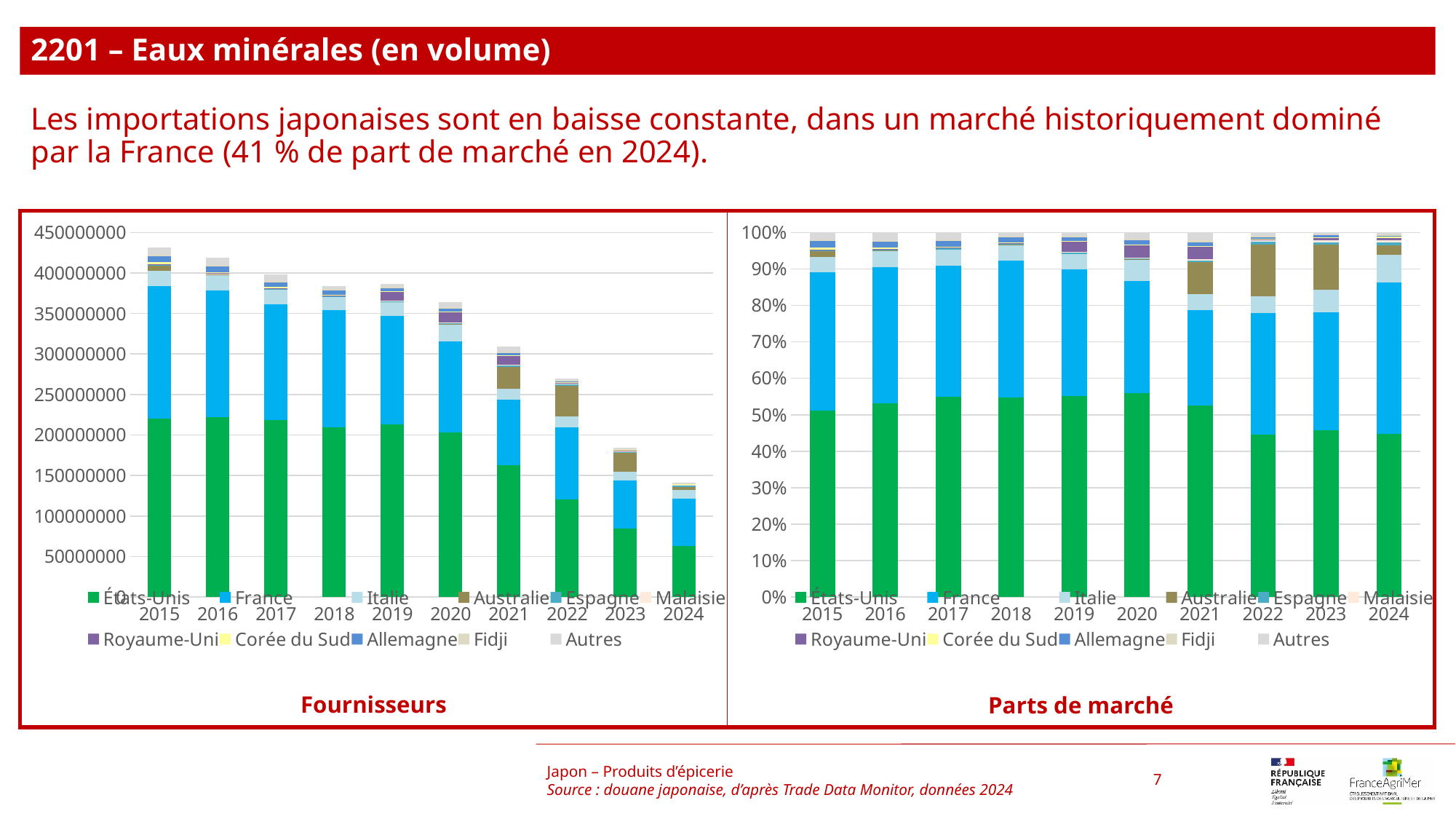
In the 'Fournisseurs' chart, do the total bar heights rise or fall from 2015 to 2024? fall In the 'Parts de marché' chart, is the États-Unis share in 2024 greater or less than 50%? less In the 'Fournisseurs' chart, is the États-Unis value for 2015 greater or less than 200000000? greater In the 'Fournisseurs' chart, which year has the lowest total bar? 2024 How many years are shown on the x axis of the 'Fournisseurs' chart? 10 In the 'Fournisseurs' chart, which year has the highest total bar? 2015 What kind of chart is the 'Fournisseurs' chart on the left? stacked bar chart In the 'Parts de marché' chart, is the États-Unis share in 2020 greater or less than 50%? greater What is the title of the chart on the right of the slide? Parts de marché How many series does the legend of the 'Parts de marché' chart list? 11